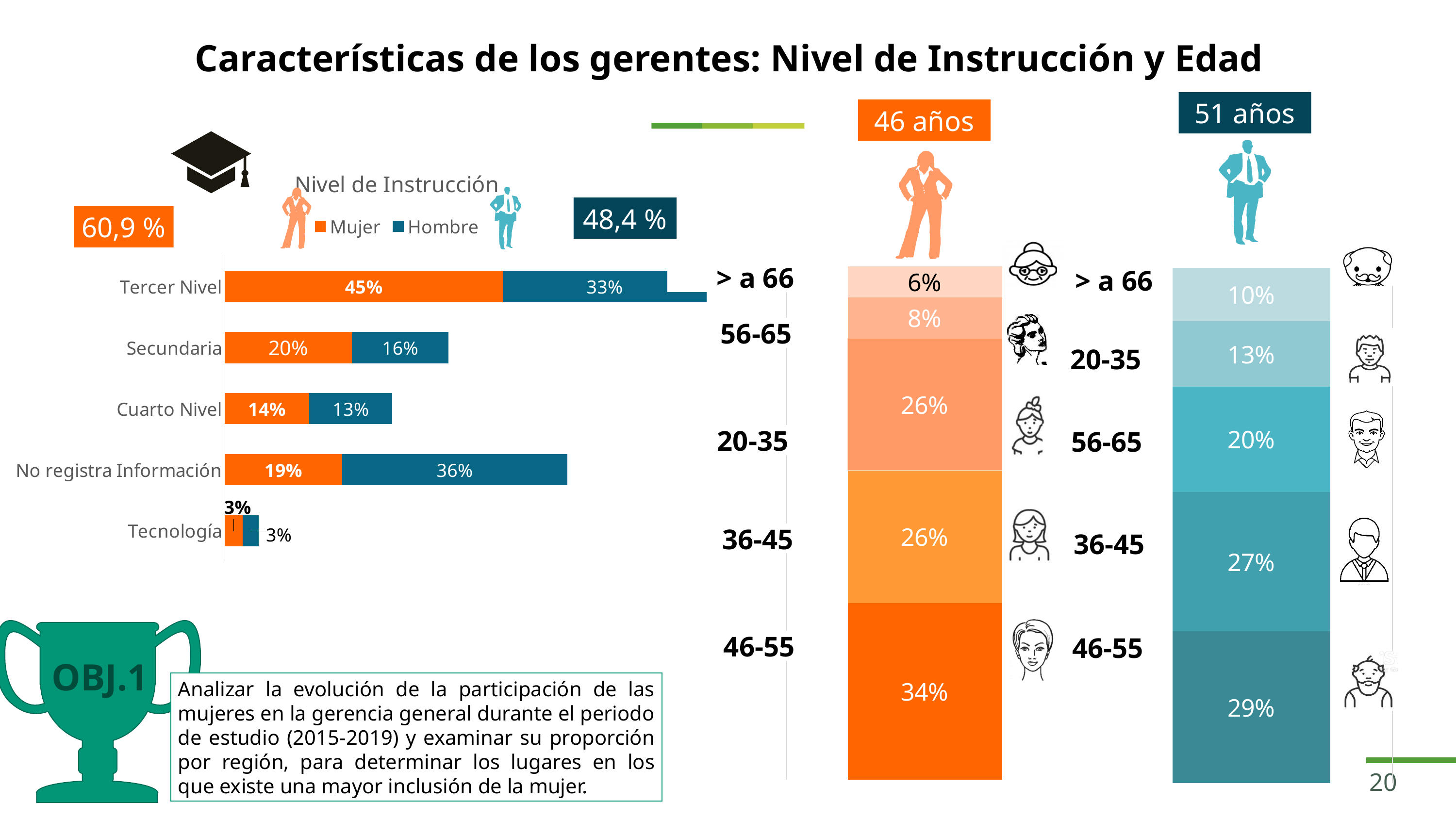
In the Nivel de Instrucción chart, which category has the highest Mujer value? Tercer Nivel In the orange stacked age chart for women (46 años), what is the value for the 46-55 age group? 34% In the Nivel de Instrucción chart, what is the Hombre value for No registra Información? 36% In the Nivel de Instrucción chart, which category has the lowest Hombre value? Tecnología In the Nivel de Instrucción chart, what is the Mujer value for Tercer Nivel? 45% How many categories are shown in the Nivel de Instrucción chart? 5 In the teal stacked age chart for men (51 años), what is the difference between the 46-55 and 36-45 values? 2% What kind of chart is the Nivel de Instrucción chart? Bar chart In the Nivel de Instrucción chart, what is the difference between the Mujer and Hombre values for Secundaria? 4% How many series does the legend of the Nivel de Instrucción chart list? 2 In the Nivel de Instrucción chart, which is larger for No registra Información, the Mujer value or the Hombre value? Hombre In the teal stacked age chart for men (51 años), which age group has the lowest value? > a 66